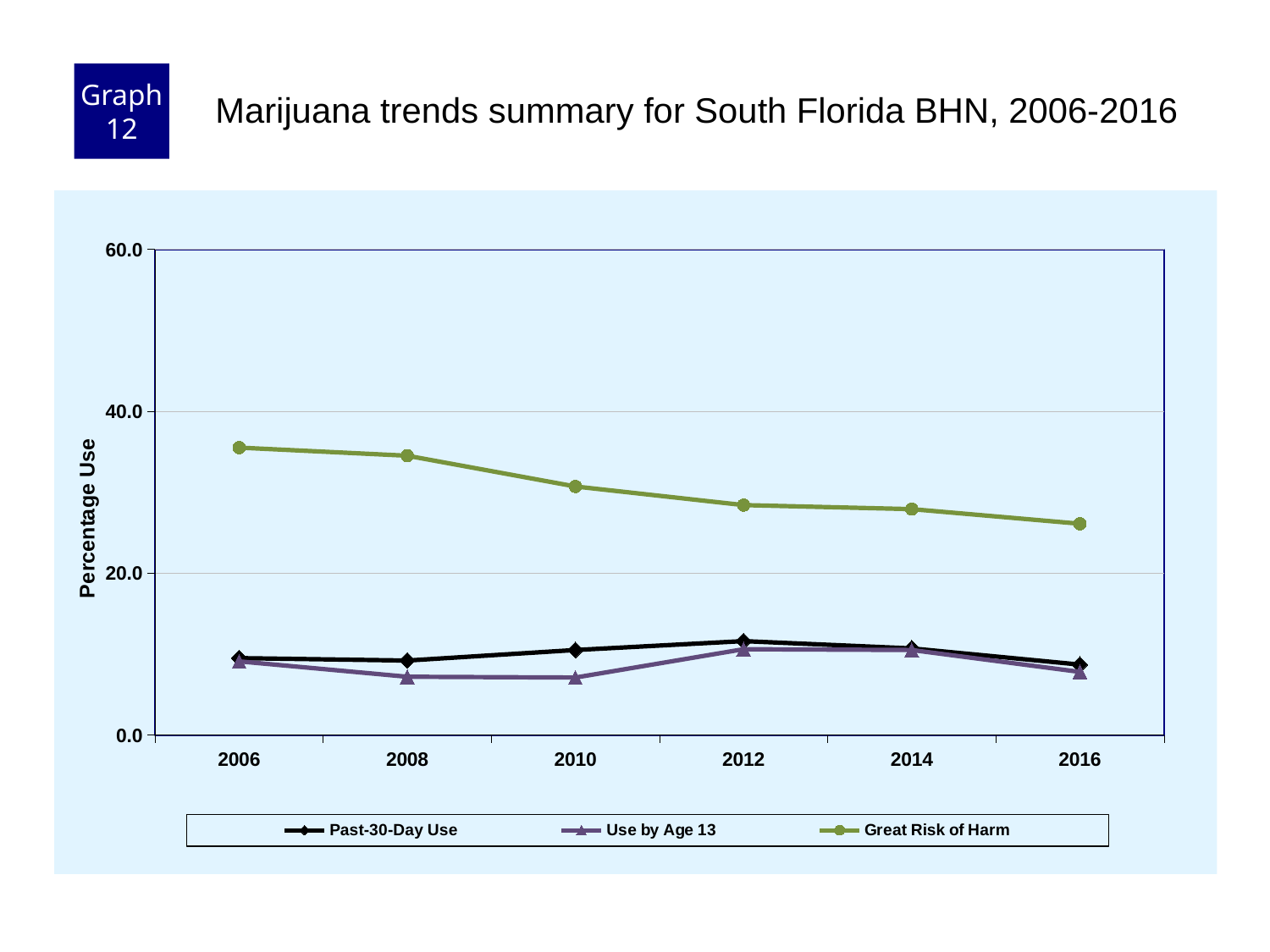
Does the Great Risk of Harm series rise or fall from 2006 to 2016? fall Is the Past-30-Day Use value for 2012 greater or less than 20.0? less Is the Great Risk of Harm value for 2006 greater or less than 40.0? less How many years are plotted along the x axis? 6 Is the Great Risk of Harm value for 2016 greater or less than 20.0? greater What kind of chart is shown on the slide? line chart What is the title of the chart? Marijuana trends summary for South Florida BHN, 2006-2016 What is the label on the y axis? Percentage Use In which year is the Great Risk of Harm value highest? 2006 In which year is the Great Risk of Harm value lowest? 2016 In 2010, which series has the larger value: Great Risk of Harm or Past-30-Day Use? Great Risk of Harm How many series does the legend list? 3